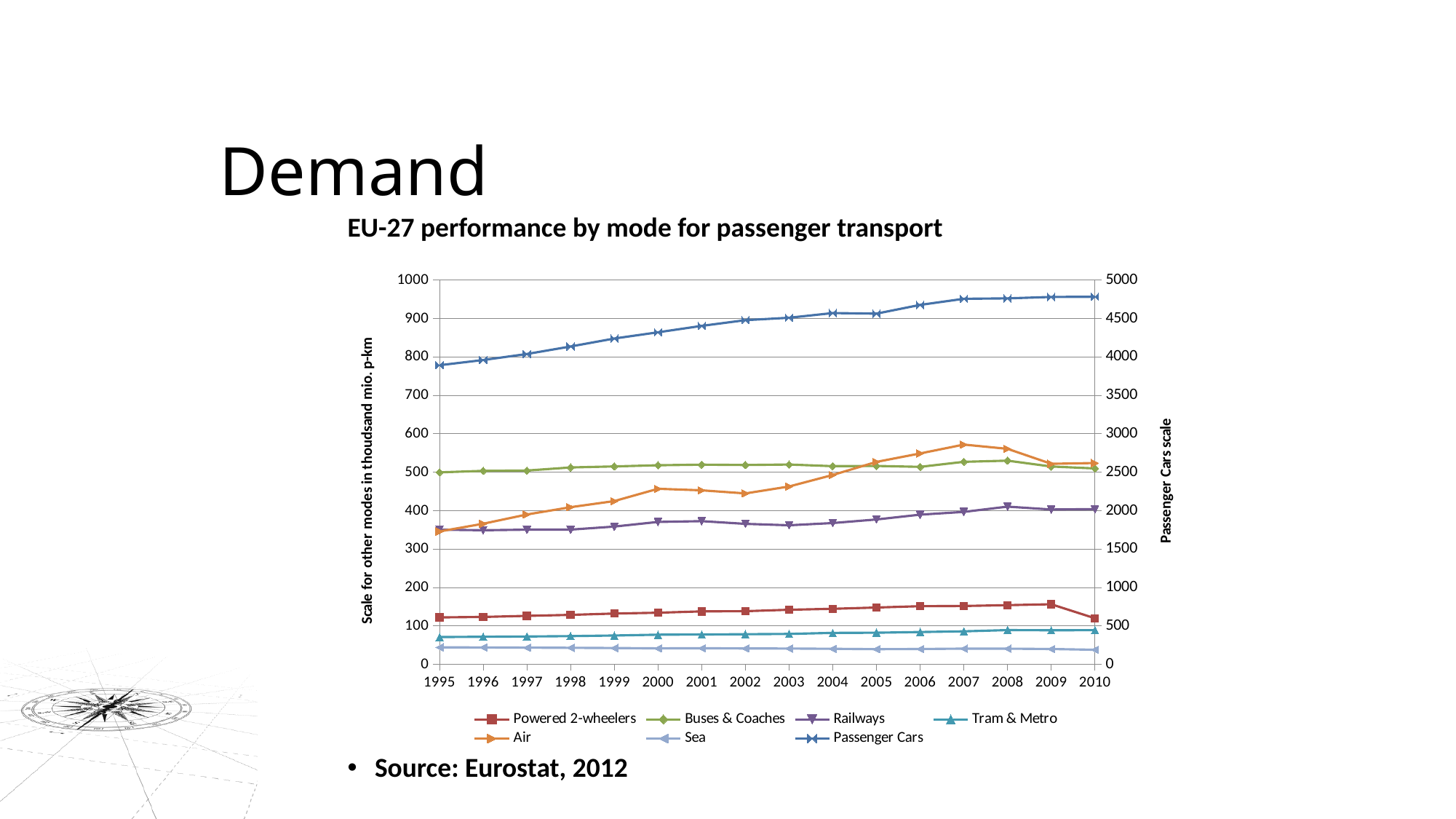
Which series has the lowest value in 2010? Sea Is the value for Passenger Cars in 2010 greater or less than 4500 on the right-hand axis? greater Is the value for Air in 2007 greater or less than 500? greater Is the value for Railways in 2010 greater or less than 300? greater How many years are plotted along the x axis? 16 What is the title of the chart? EU-27 performance by mode for passenger transport In 2007, which is higher: Air or Buses & Coaches? Air Do the values for Passenger Cars rise or fall from 1995 to 2010? rise How many series does the legend list? 7 What kind of chart is shown on the slide? line chart Which series is plotted against the right-hand 'Passenger Cars scale' axis? Passenger Cars